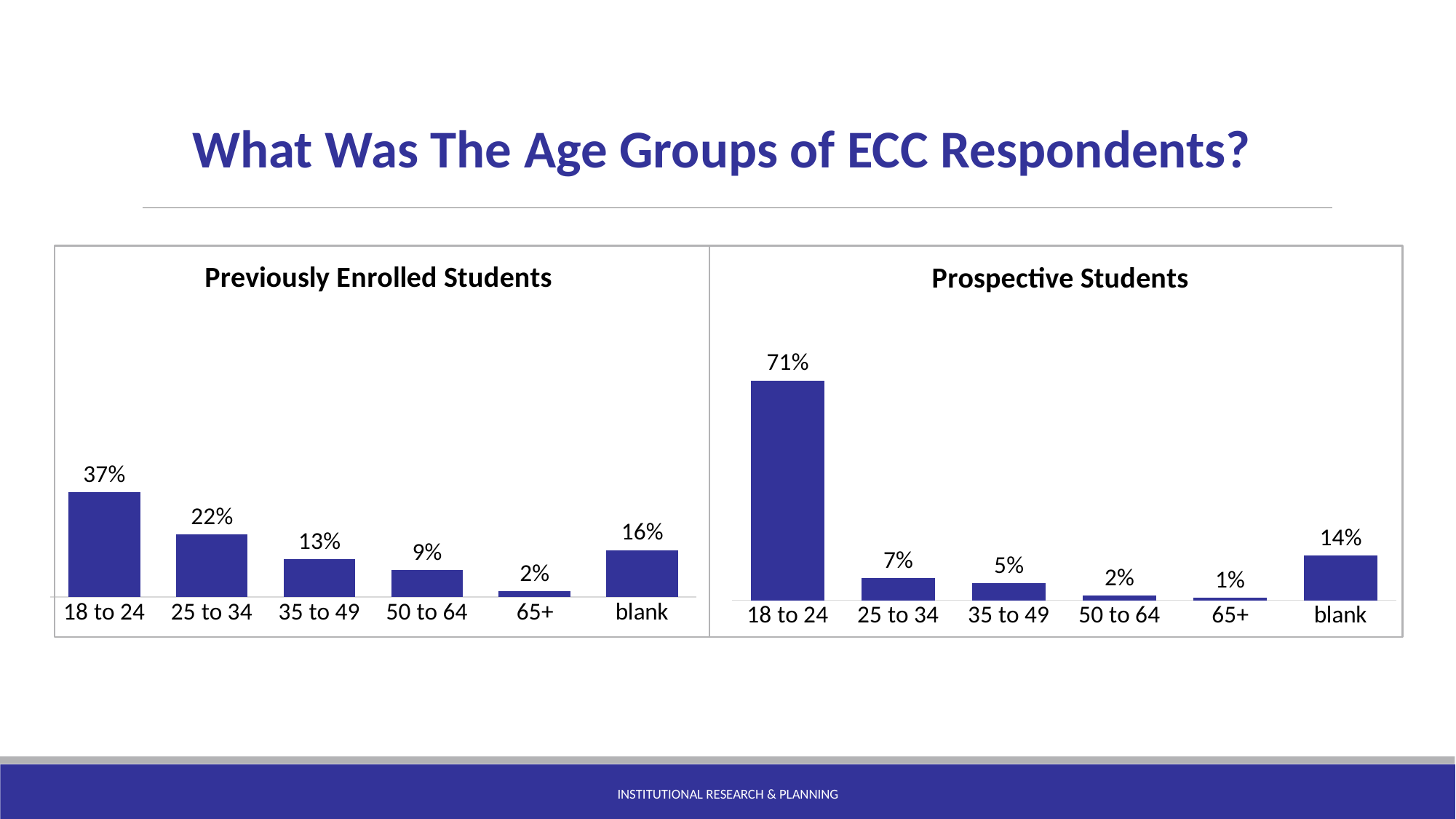
In the Prospective Students chart, which category has the lowest value? 65+ What kind of chart is the Previously Enrolled Students chart? Bar chart What is the title of the chart on the right side of the slide? Prospective Students In the Prospective Students chart, which age group has the highest value? 18 to 24 In the Previously Enrolled Students chart, what is the value for blank? 16% In the Prospective Students chart, what is the difference between the values for 18 to 24 and blank? 57% Which is larger: the value for 35 to 49 in the Previously Enrolled Students chart or the value for 35 to 49 in the Prospective Students chart? Previously Enrolled Students In the Previously Enrolled Students chart, which category has the lowest value? 65+ In the Previously Enrolled Students chart, what is the value for 18 to 24? 37% How many categories are shown in the Prospective Students chart? 6 In the Previously Enrolled Students chart, what is the difference between the values for 18 to 24 and 25 to 34? 15% In the Prospective Students chart, what is the value for 25 to 34? 7%